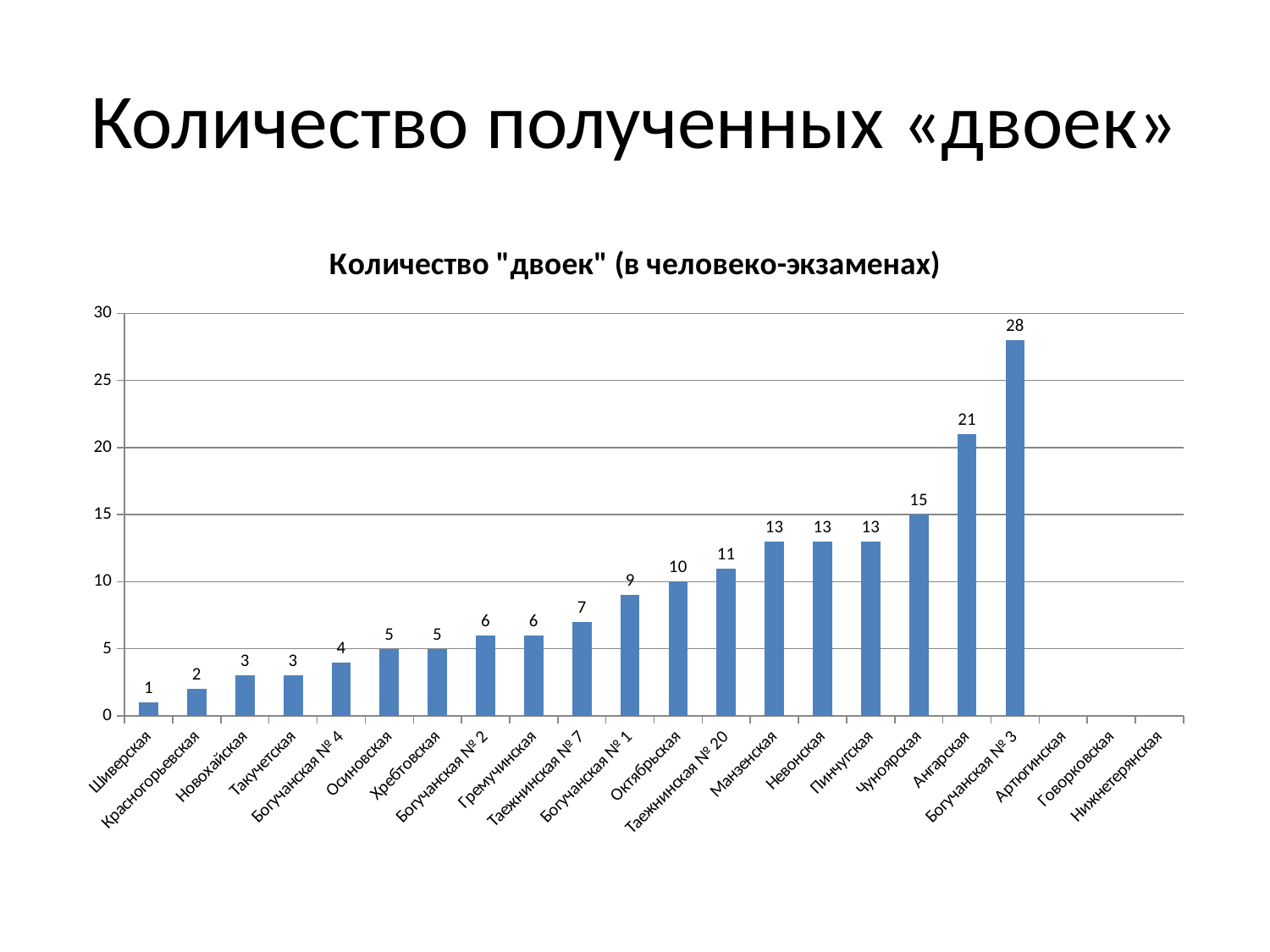
Which category has the highest value? Богучанская № 3 Do the bar values generally rise or fall from left to right along the x axis? rise What is the value for Ангарская? 21 Which is larger, the value for Ангарская or the value for Чуноярская? Ангарская How many categories have a value of 13? 3 What is the difference between the values for Богучанская № 3 and Ангарская? 7 What is the value for Богучанская № 3? 28 Is the value for Таежнинская № 20 greater or less than 15? less What is the value for Октябрьская? 10 What is the title of the chart? Количество "двоек" (в человеко-экзаменах) What kind of chart is shown on the slide? bar chart What is the value for Шиверская? 1